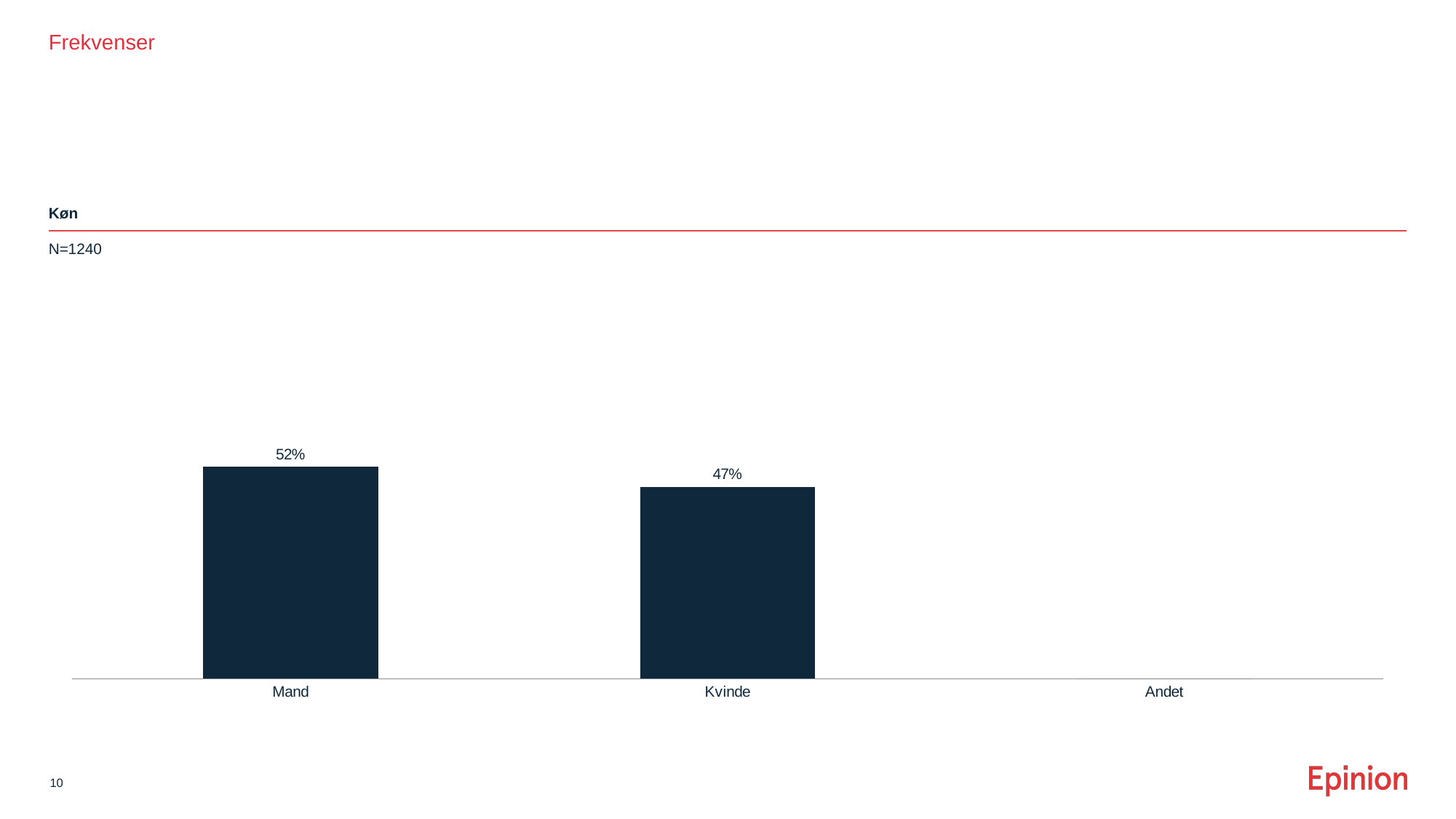
What is the sample size (N) stated for the chart? N=1240 What kind of chart is shown on the slide? Bar chart Which category has the highest value? Mand Which category has no visible bar? Andet What is the value for Kvinde? 47% What is the value for Mand? 52% What is the difference between the values for Mand and Kvinde? 5% How many categories are shown on the x axis? 3 Which is larger, the value for Mand or the value for Kvinde? Mand What is the title of the chart? Køn